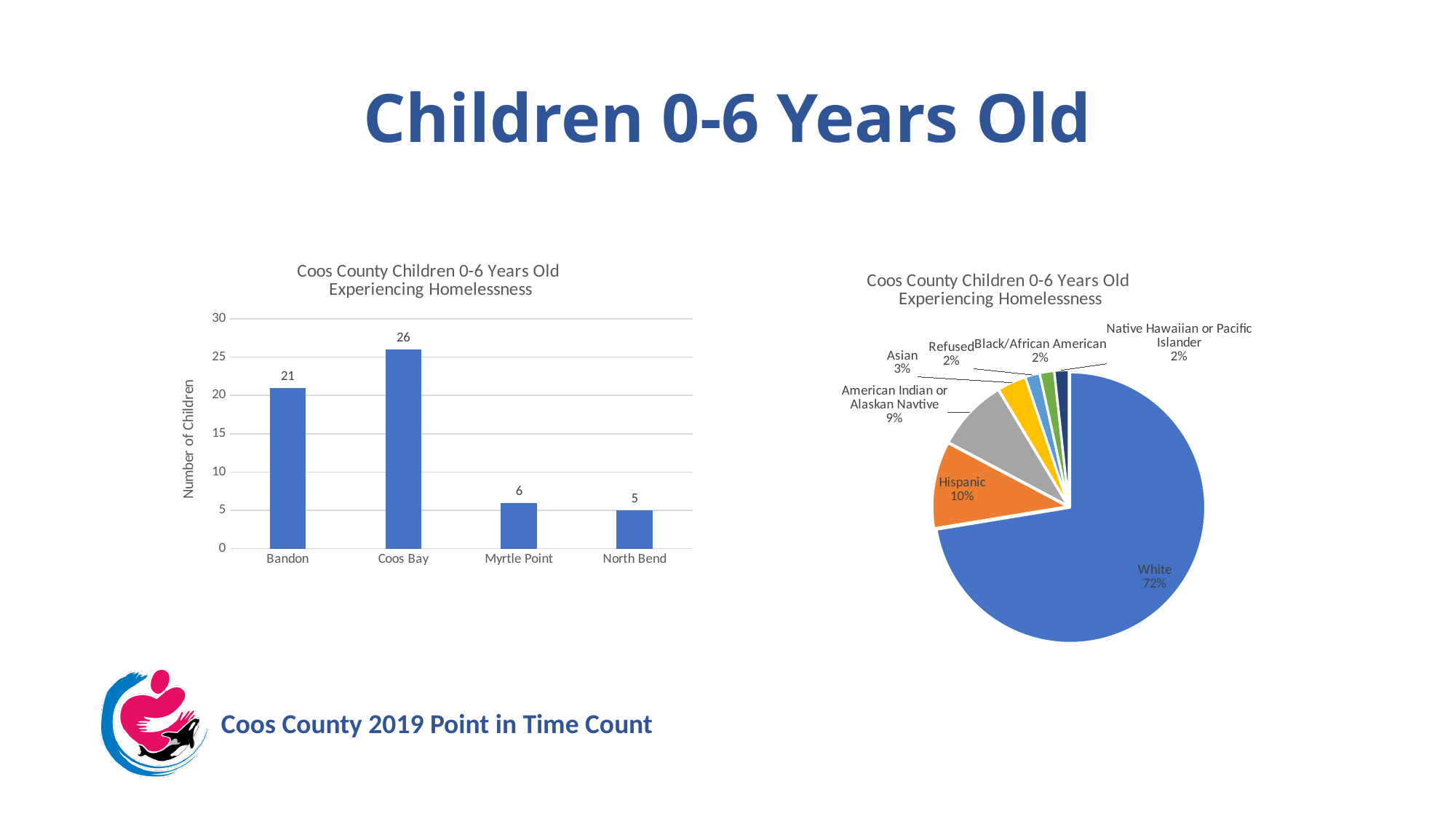
In the pie chart on the right, what percentage is shown for American Indian or Alaskan Native? 9% In the bar chart on the left, which location has the highest number of children? Coos Bay In the bar chart on the left, how many children are shown for Bandon? 21 In the bar chart on the left, which is larger, the value for Myrtle Point or the value for North Bend? Myrtle Point In the bar chart on the left, how many locations are shown on the x axis? 4 In the pie chart on the right, what share of the pie is White? 72% In the bar chart on the left, which location has the lowest number of children? North Bend In the pie chart on the right, what percentage is shown for Hispanic? 10% In the bar chart on the left, what is the difference between the values for Coos Bay and Bandon? 5 What is the y-axis label of the bar chart on the left? Number of Children What type of chart is the chart on the left of the slide? Bar chart In the bar chart on the left, how many children are shown for Coos Bay? 26